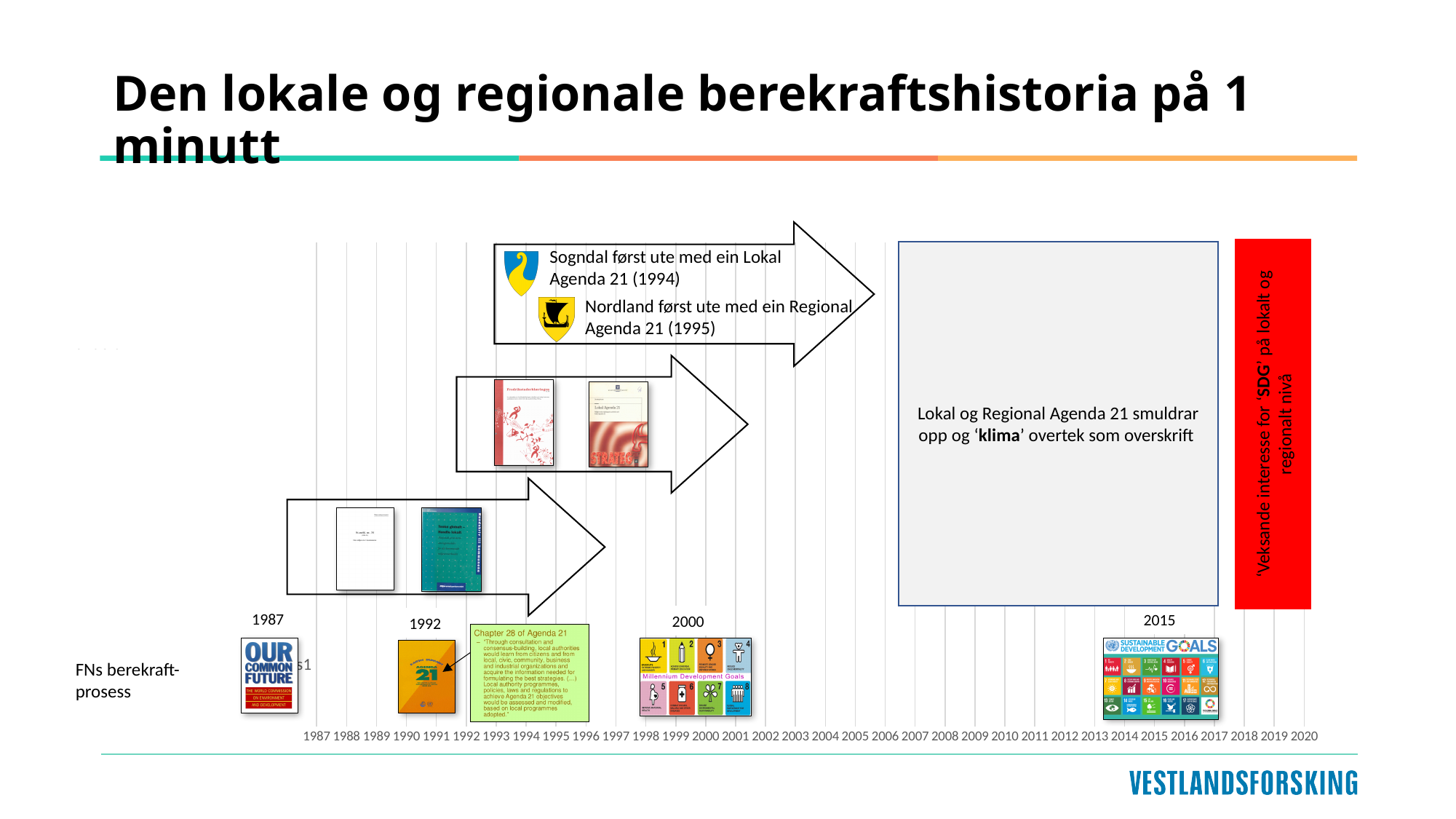
What is the first year shown on the horizontal axis of the timeline? 1987 Which year is labelled above the Millennium Development Goals image on the timeline? 2000 Which year is labelled above the 'Our Common Future' report on the timeline? 1987 How many year labels are shown along the horizontal axis of the timeline? 34 Which year is labelled above the Agenda 21 document on the timeline? 1992 What is the label at the left of the bottom row of the timeline? FNs berekraft-prosess Which year is labelled above the Sustainable Development Goals image on the timeline? 2015 What is the title of the slide containing the timeline? Den lokale og regionale berekraftshistoria på 1 minutt Do the year labels along the horizontal axis increase or decrease from left to right? increase What is the last year shown on the horizontal axis of the timeline? 2020